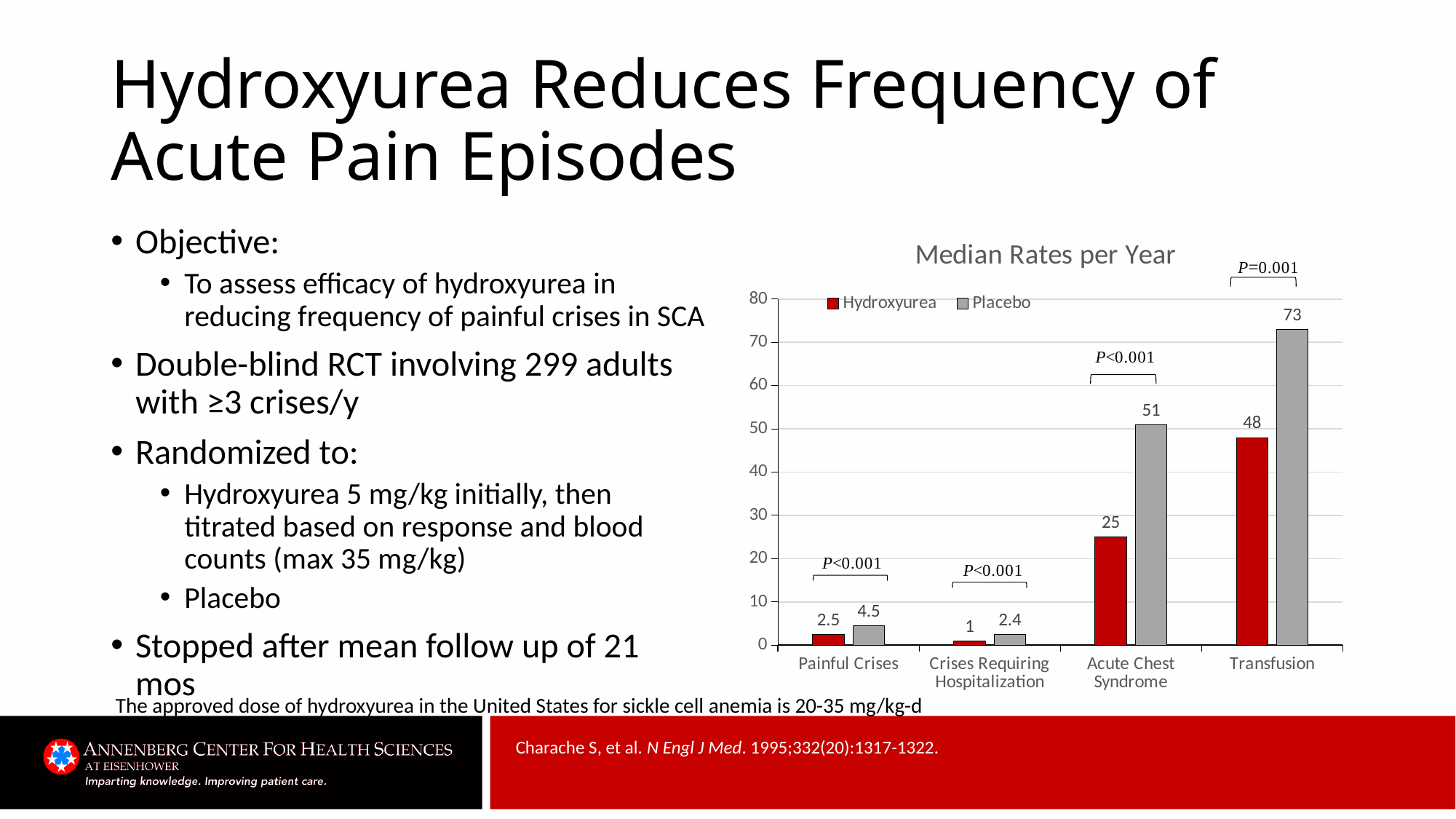
What is the Placebo value for Transfusion? 73 What is the difference between the Placebo and Hydroxyurea values for Acute Chest Syndrome? 26 What is the Placebo value for Crises Requiring Hospitalization? 2.4 Which is larger for Painful Crises, the Hydroxyurea value or the Placebo value? Placebo How many categories are shown on the x axis? 4 What is the Hydroxyurea value for Painful Crises? 2.5 What is the difference between the Placebo and Hydroxyurea values for Transfusion? 25 What is the Hydroxyurea value for Acute Chest Syndrome? 25 Which category has the lowest Hydroxyurea value? Crises Requiring Hospitalization What type of chart is shown? Bar chart How many series does the legend list? 2 Which category has the highest Placebo value? Transfusion